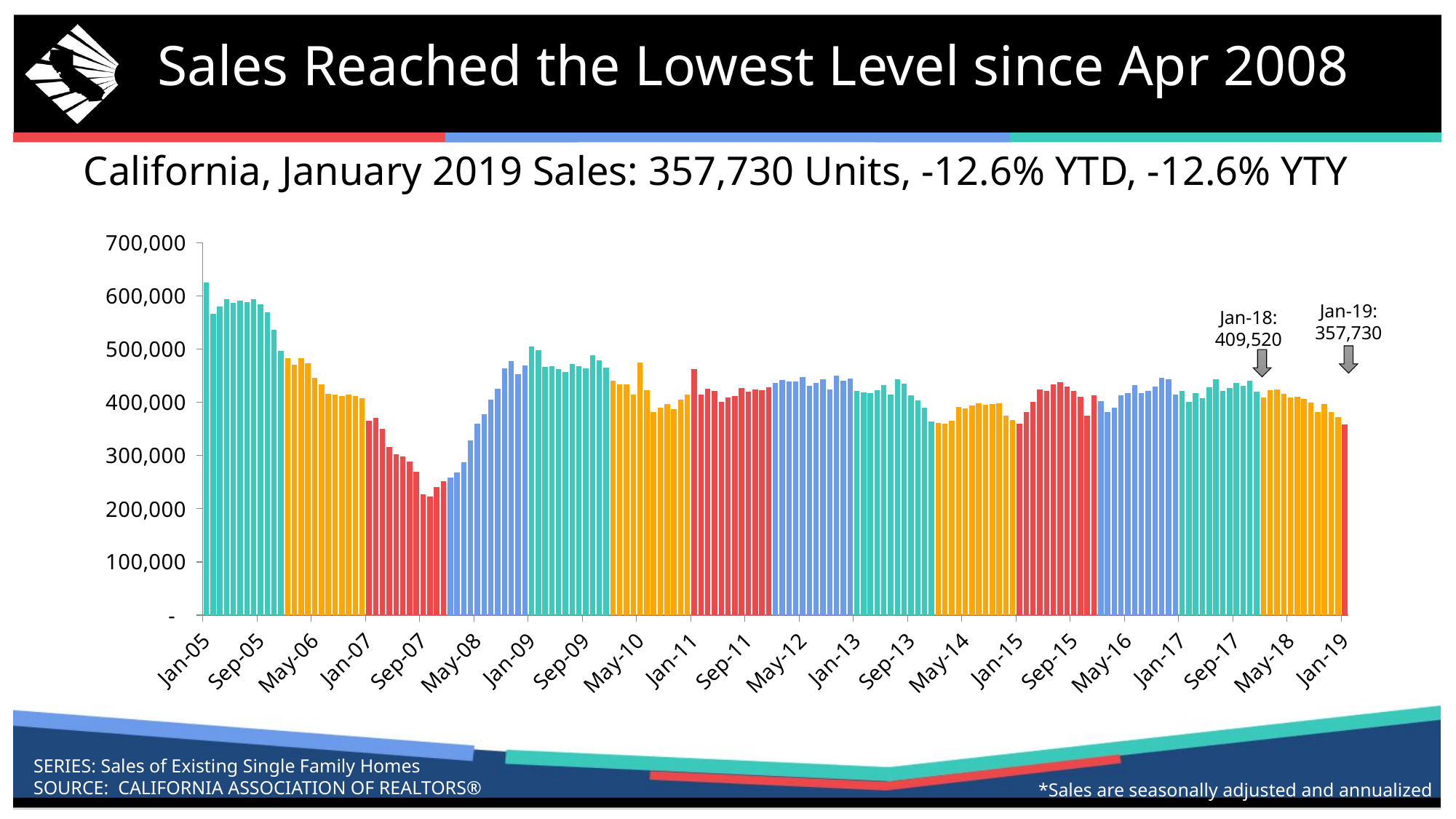
What is the sales value labeled for Jan-19 on the chart? 357,730 What is the title of the slide? Sales Reached the Lowest Level since Apr 2008 Is the value for Jan-05 greater or less than 600,000? greater What is the sales value labeled for Jan-18 on the chart? 409,520 Which month had higher sales, Jan-18 or Jan-19? Jan-18 What is the year-to-year (YTY) percentage change in sales stated on the slide? -12.6% Is the value for Jan-19 greater or less than 400,000? less Is the value for Jan-09 greater or less than 400,000? greater Which month on the x axis has the highest sales value in the chart? Jan-05 By how much did sales fall from Jan-18 to Jan-19, according to the labeled values? 51,790 Do sales rise or fall from May-18 to Jan-19? fall What kind of chart is shown on the slide? Bar chart